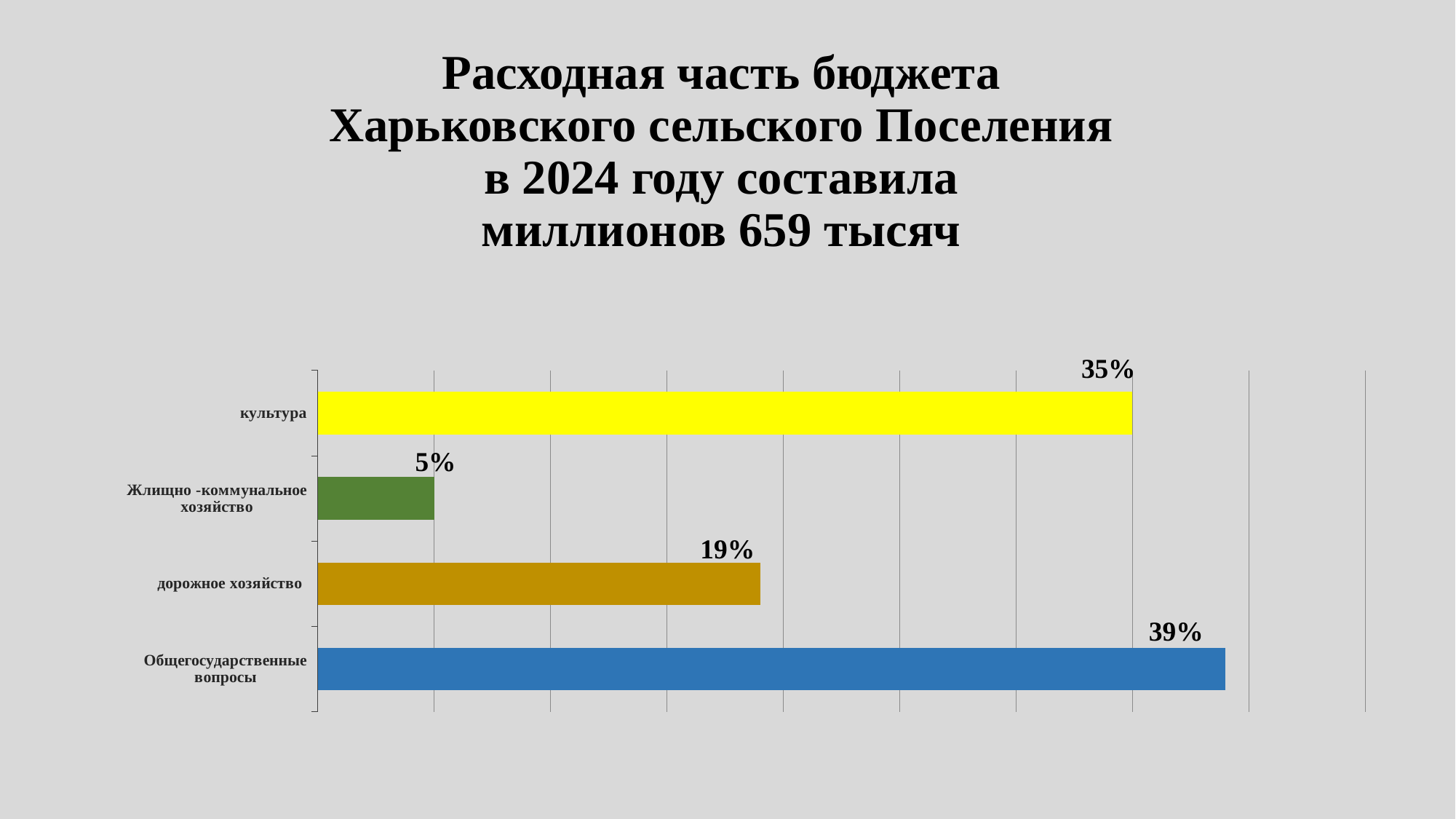
Which is larger, the value for культура or the value for дорожное хозяйство? культура What is the value for Жлищно -коммунальное хозяйство? 5% Which category has the lowest value? Жлищно -коммунальное хозяйство What is the difference between the values for Общегосударственные вопросы and культура? 4% What colour is the bar for культура? yellow Which category has the highest value? Общегосударственные вопросы What is the value for дорожное хозяйство? 19% How many categories are shown in the chart? 4 What kind of chart is shown on the slide? bar chart What is the difference between the values for дорожное хозяйство and Жлищно -коммунальное хозяйство? 14% What is the value for Общегосударственные вопросы? 39% What is the value for культура? 35%